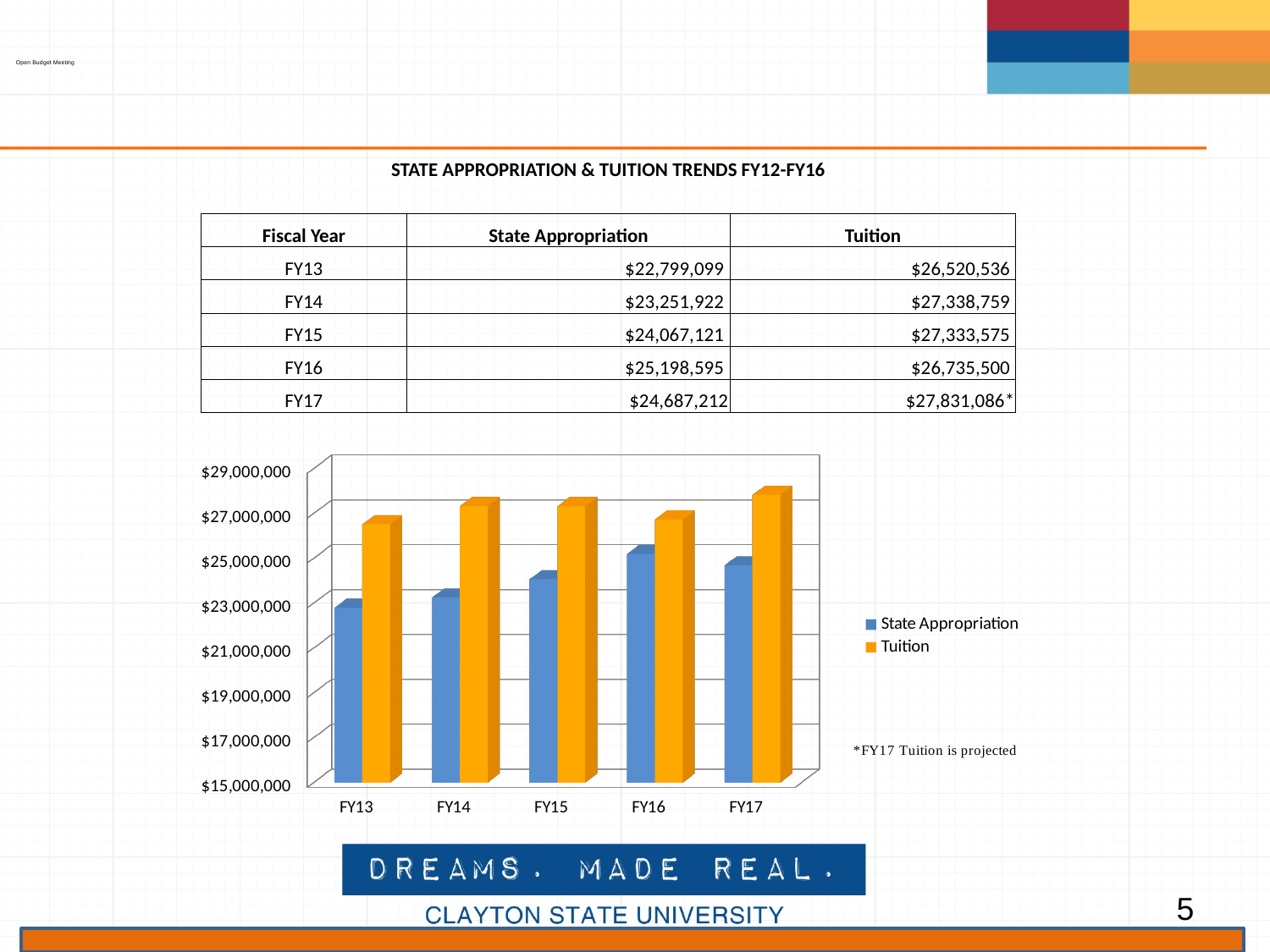
Is the State Appropriation bar for FY13 greater or less than $23,000,000? less How many fiscal years are plotted on the x axis of the chart? 5 Which fiscal year has the lowest Tuition? FY13 What is the difference between Tuition and State Appropriation in FY13? $3,721,437 Which fiscal year has the highest State Appropriation? FY16 Which is larger, the State Appropriation for FY15 or for FY16? FY16 How many series does the chart legend list? 2 Does the State Appropriation rise or fall from FY13 to FY16? rise What is the State Appropriation value for FY16? $25,198,595 What is the Tuition value for FY17? $27,831,086 What colour represents Tuition in the chart? Orange What kind of chart is shown on the slide? Bar chart